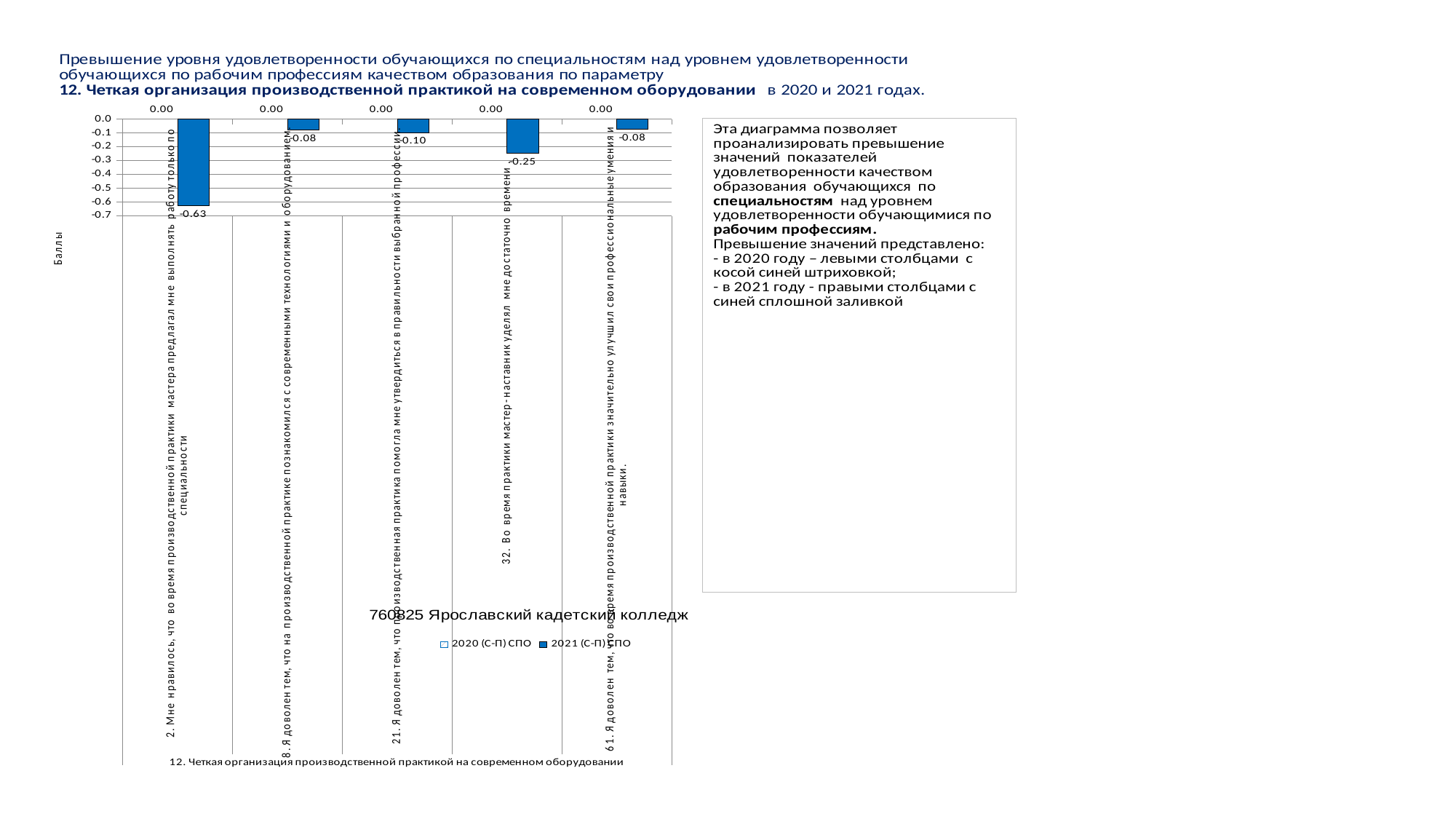
What is the 2021 (С-П) СПО value for statement 2 (Мне нравилось, что во время производственной практики мастер предлагал мне выполнять работу только по специальности)? -0.63 How many categories (statements) are plotted on the chart? 5 What is the title printed on the chart? 760325 Ярославский кадетский колледж What is the 2020 (С-П) СПО value for statement 8 (Я доволен тем, что на производственной практике познакомился с современными технологиями и оборудованием)? 0.00 What is the 2021 (С-П) СПО value for statement 21 (Я доволен тем, что производственная практика помогла мне утвердиться в правильности выбранной профессии)? -0.10 What type of chart is shown on the slide? bar chart What is the label of the vertical axis? Баллы What is the 2021 (С-П) СПО value for statement 32 (Во время практики мастер-наставник уделял мне достаточно времени)? -0.25 What is the difference between the 2021 (С-П) СПО values for statement 2 and statement 32? 0.38 Which is larger for 2021 (С-П) СПО: the value for statement 8 or the value for statement 32? statement 8 Which statement has the lowest 2021 (С-П) СПО value? 2. Мне нравилось, что во время производственной практики мастер предлагал мне выполнять работу только по специальности How many series does the chart legend list? 2